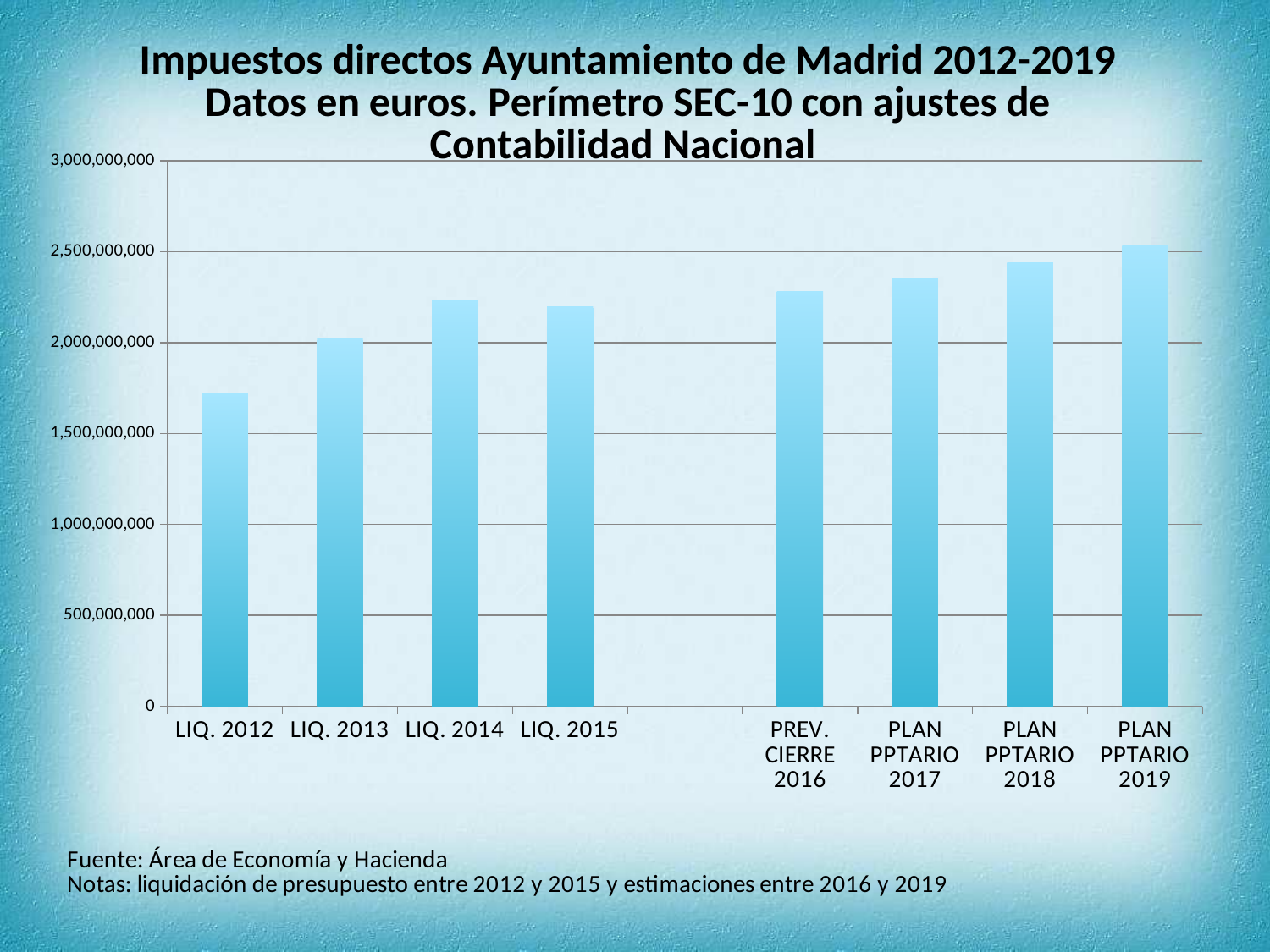
Is the value for PREV. CIERRE 2016 greater or less than 2,500,000,000? less Is the value for PLAN PPTARIO 2018 greater or less than 2,500,000,000? less Which category has the highest value in the chart? PLAN PPTARIO 2019 What kind of chart is shown on the slide? Bar chart Which is larger, the value for PLAN PPTARIO 2018 or the value for LIQ. 2013? PLAN PPTARIO 2018 What is the highest value shown on the vertical axis of the chart? 3,000,000,000 Which category has the lowest value in the chart? LIQ. 2012 Do the values generally rise or fall from LIQ. 2012 to PLAN PPTARIO 2019? rise Is the value for LIQ. 2014 greater or less than 2,000,000,000? greater Which is larger, the value for LIQ. 2014 or the value for LIQ. 2012? LIQ. 2014 How many bars (categories) are plotted in the chart? 8